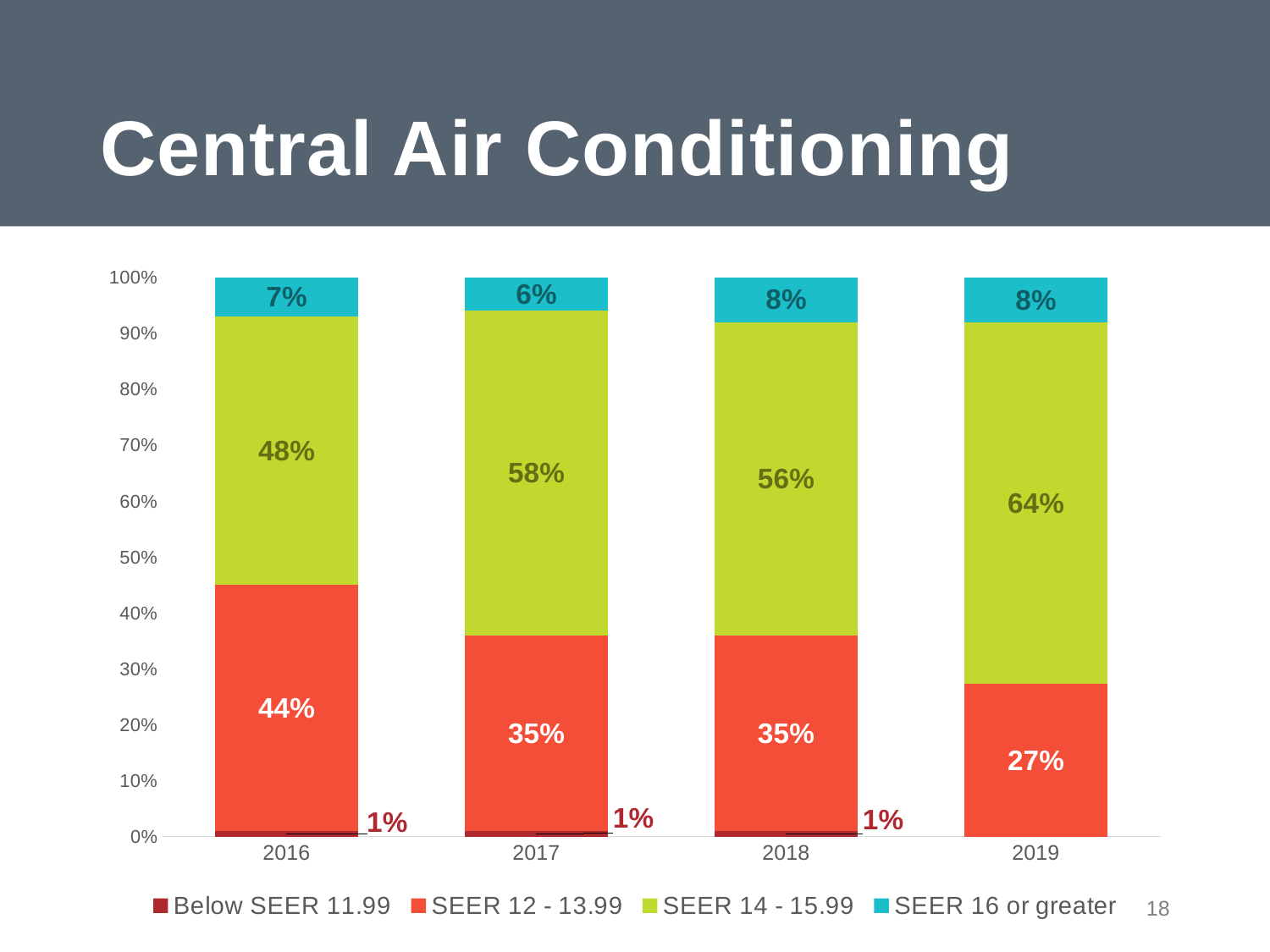
Does the SEER 12 - 13.99 share generally rise or fall from 2016 to 2019? Fall In which year was the SEER 12 - 13.99 share the lowest? 2019 What share of units in 2017 were SEER 16 or greater? 6% How many years are shown on the x axis? 4 What kind of chart is shown on the slide? Stacked bar chart What share of units in 2016 were SEER 12 - 13.99? 44% In which year was the SEER 14 - 15.99 share the highest? 2019 What share of central air conditioning units in 2019 were SEER 14 - 15.99? 64% Which is larger: the SEER 16 or greater share in 2016 or in 2018? 2018 How many series does the legend list? 4 By how many percentage points did the SEER 14 - 15.99 share in 2019 exceed that in 2016? 16% What share of units in 2018 were Below SEER 11.99? 1%